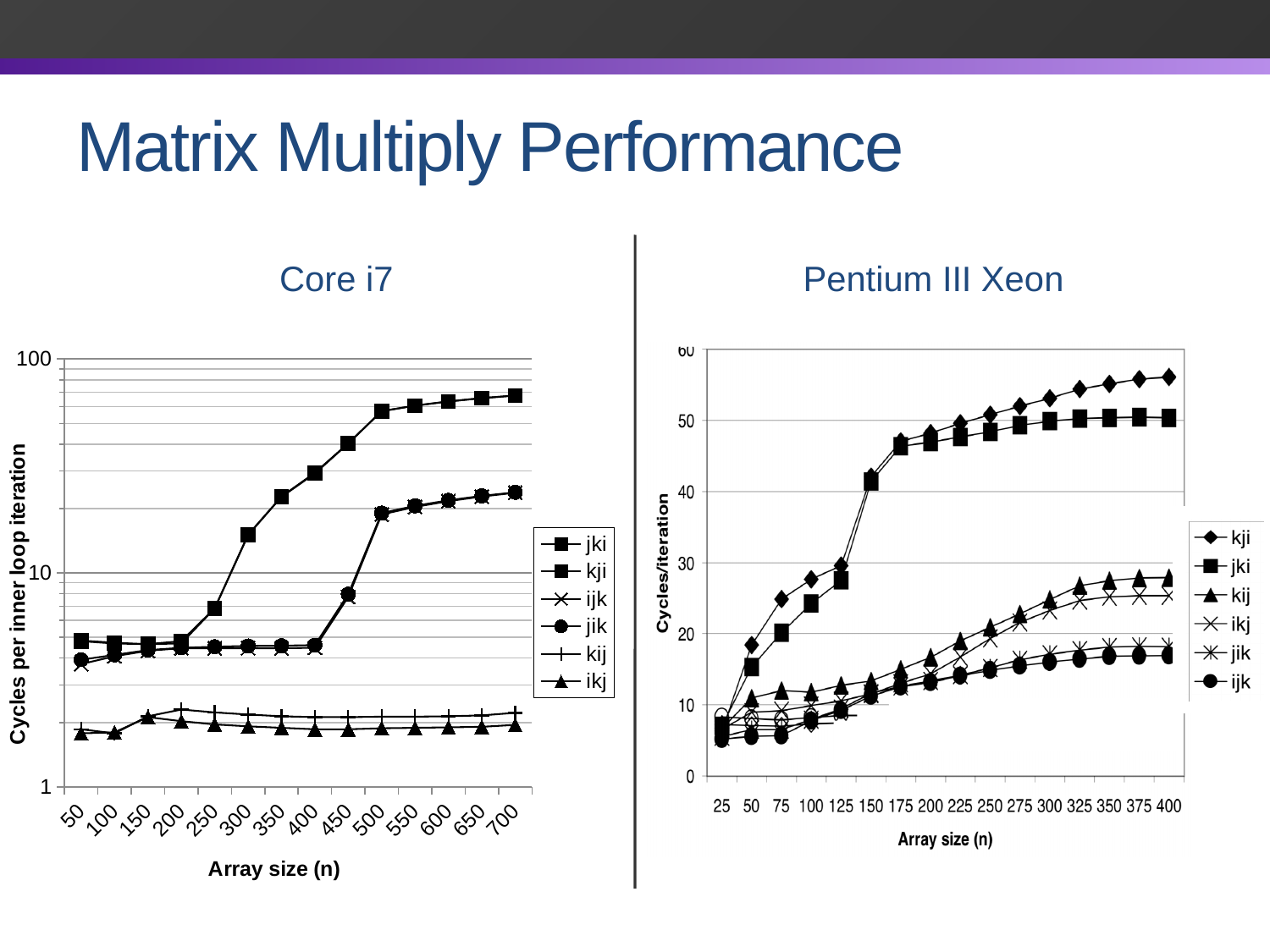
How many series does the legend of the Pentium III Xeon chart list? 6 In the Core i7 chart, is the value for jki at array size 50 greater or less than 10? less What kind of chart is the Core i7 chart? line chart In the Pentium III Xeon chart, does the kji series rise or fall as array size increases? rise What is the x-axis title of the Core i7 chart? Array size (n) In the Pentium III Xeon chart, is the value for kji at array size 400 greater or less than 50? greater In the Pentium III Xeon chart, is the value for ijk at array size 400 greater or less than 20? less How many array size tick labels are shown on the x axis of the Pentium III Xeon chart? 16 In the Pentium III Xeon chart, which series has the highest value at array size 400? kji How many series does the legend of the Core i7 chart list? 6